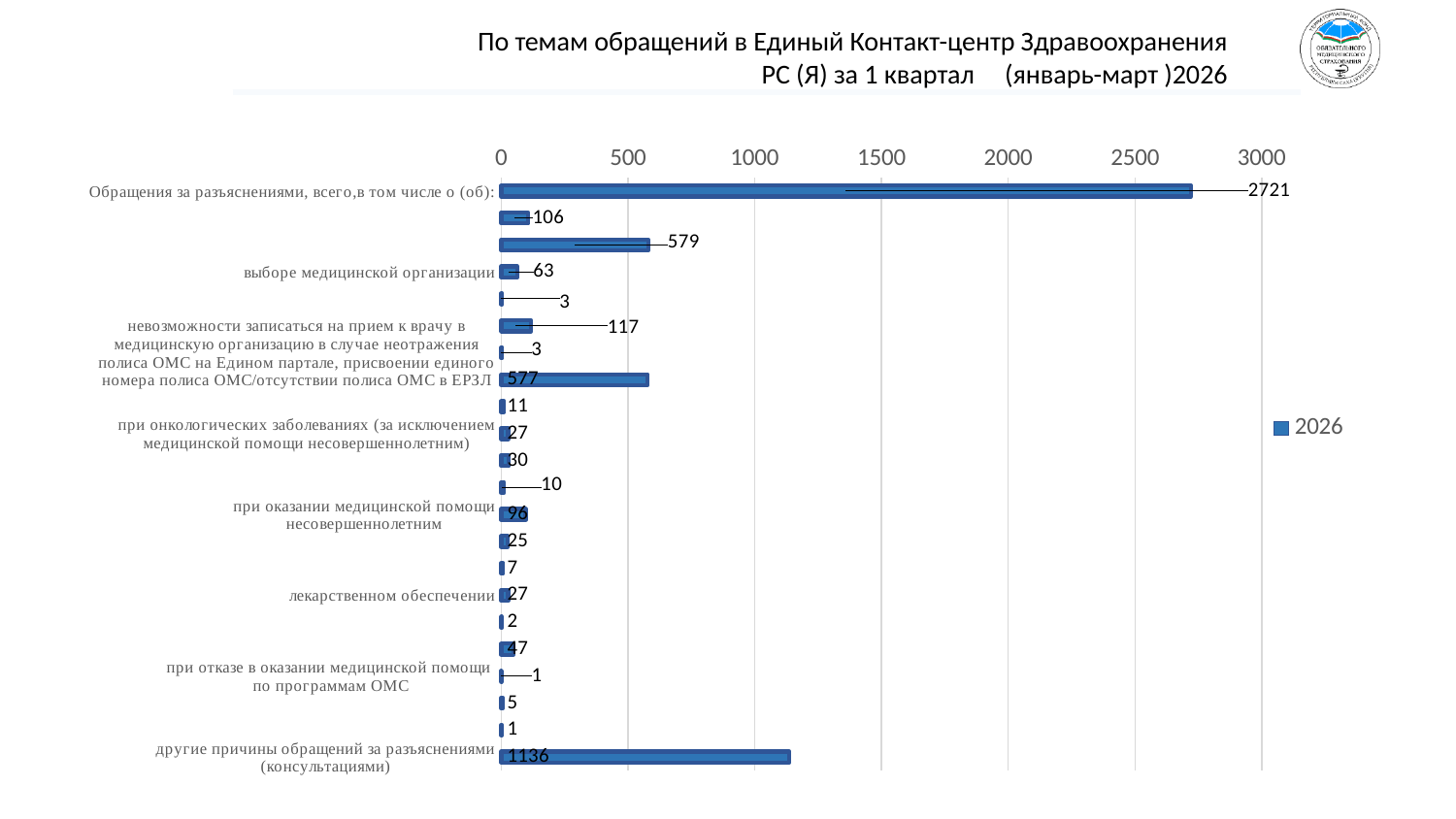
What is the value for "выборе медицинской организации"? 63 What is the value for "другие причины обращений за разъяснениями (консультациями)"? 1136 What kind of chart is shown on the slide? bar chart Which is larger: the value for "при оказании медицинской помощи несовершеннолетним" or the value for "лекарственном обеспечении"? при оказании медицинской помощи несовершеннолетним What is the value for "лекарственном обеспечении"? 27 What is the difference between the value for "Обращения за разъяснениями, всего, в том числе о (об):" and the value for "другие причины обращений за разъяснениями (консультациями)"? 1585 What series name is shown in the legend? 2026 What is the value for "при оказании медицинской помощи несовершеннолетним"? 96 Is the value for "другие причины обращений за разъяснениями (консультациями)" greater or less than 1000? greater Which category has the highest value? Обращения за разъяснениями, всего, в том числе о (об): How many series does the legend list? 1 What is the value for "Обращения за разъяснениями, всего, в том числе о (об):"? 2721